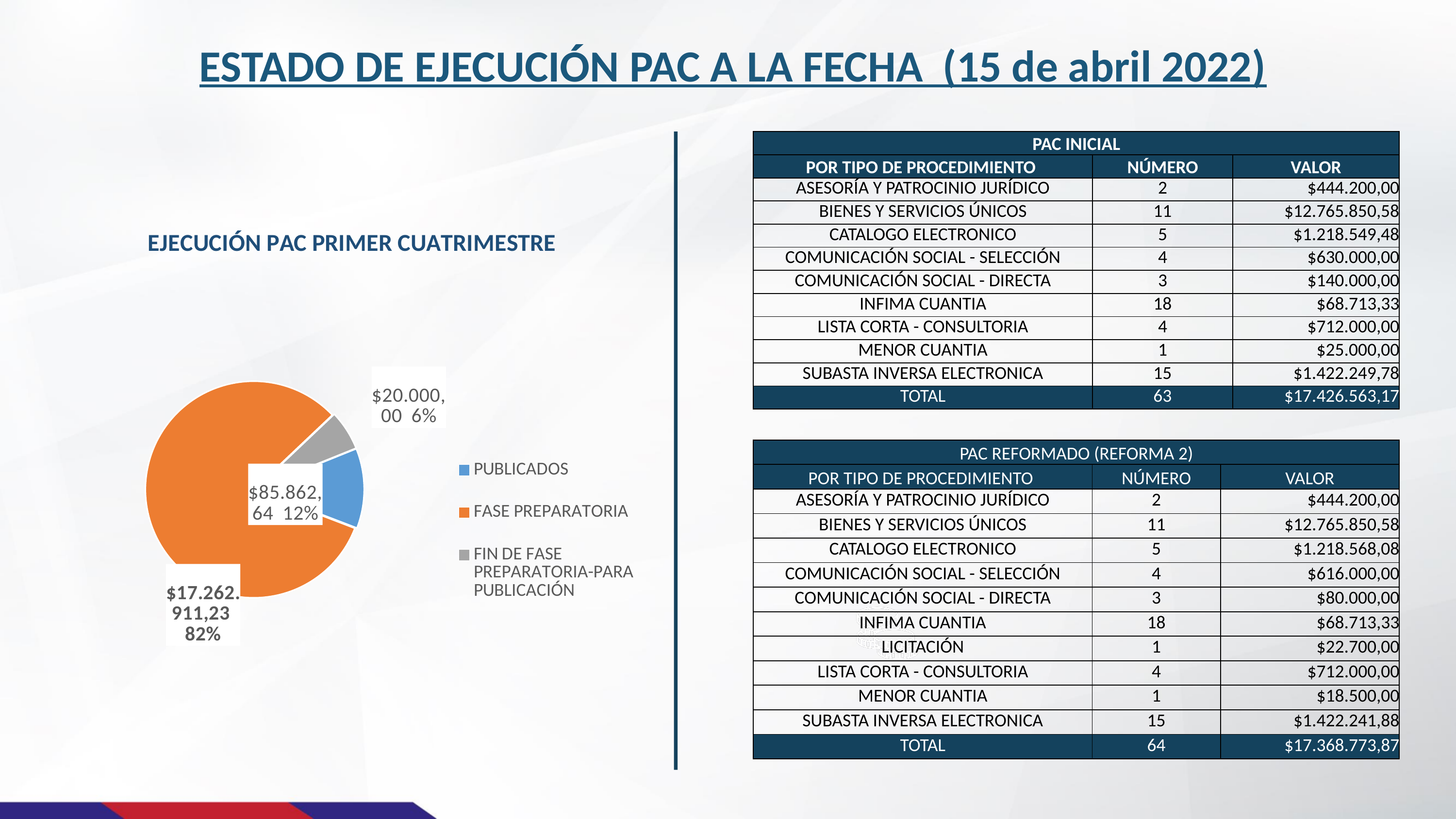
What is the value shown for FIN DE FASE PREPARATORIA-PARA PUBLICACIÓN in the pie chart? $20.000,00 Which category has the largest slice in the pie chart? FASE PREPARATORIA How many entries does the pie chart's legend list? 3 Which colour represents FASE PREPARATORIA in the pie chart? orange How many slices does the pie chart have? 3 What is the value shown for PUBLICADOS in the pie chart? $85.862,64 What share of the pie does PUBLICADOS represent? 12% What kind of chart is shown on the slide? pie chart Which category has the smallest slice in the pie chart? FIN DE FASE PREPARATORIA-PARA PUBLICACIÓN What is the title of the pie chart? EJECUCIÓN PAC PRIMER CUATRIMESTRE What is the value shown for FASE PREPARATORIA in the pie chart? $17.262.911,23 What share of the pie does FASE PREPARATORIA represent? 82%